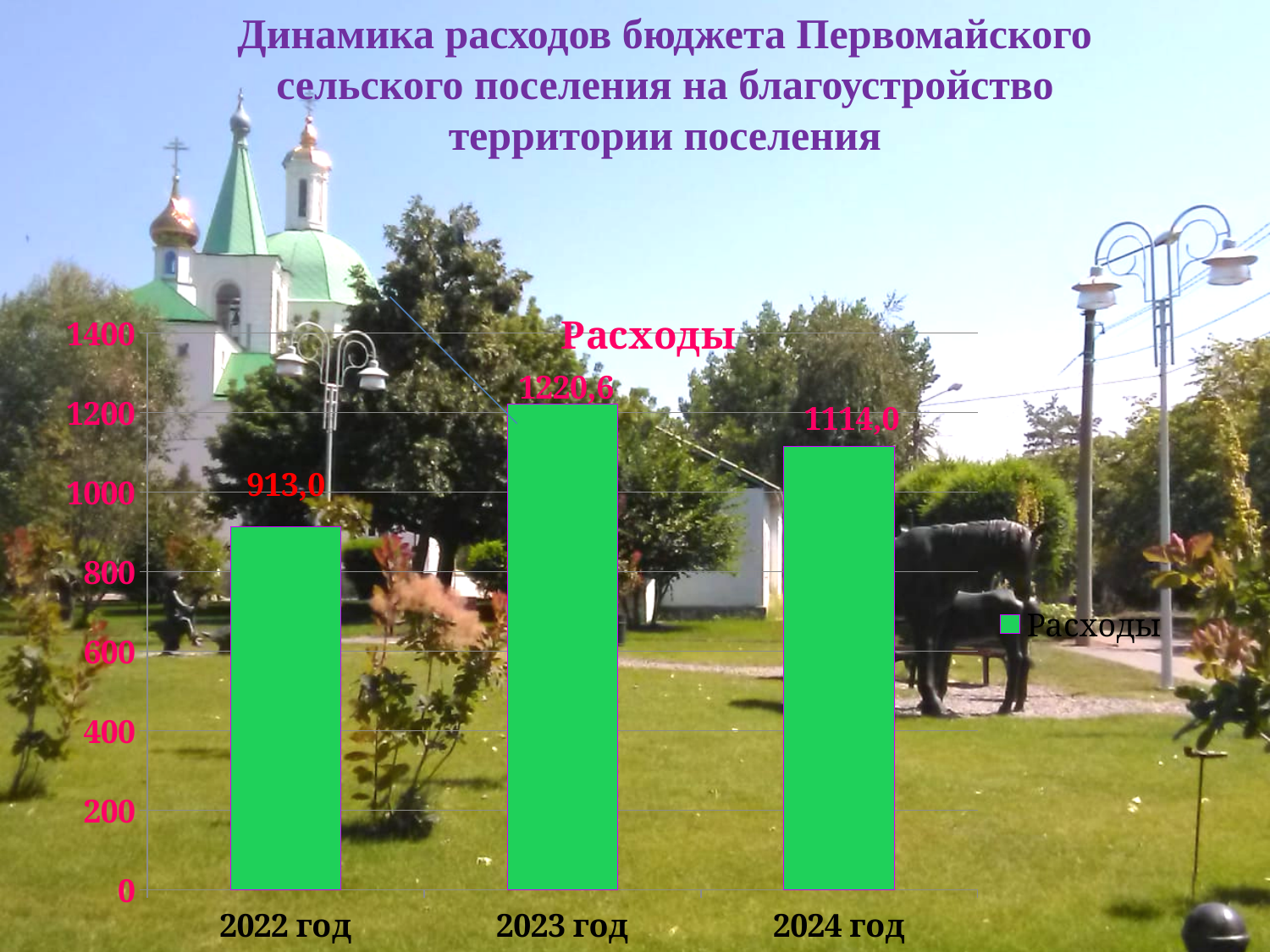
What kind of chart is shown on the slide? bar chart Which is larger, the value for 2024 год or the value for 2022 год? 2024 год What is the value for 2024 год? 1114,0 What is the difference between the values for 2023 год and 2024 год? 106,6 Which year has the highest value? 2023 год What is the value for 2023 год? 1220,6 What is the title of the chart? Расходы What is the difference between the values for 2023 год and 2022 год? 307,6 Which year has the lowest value? 2022 год Is the value for 2022 год greater or less than 1000? less What is the value for 2022 год? 913,0 How many years are shown on the chart? 3